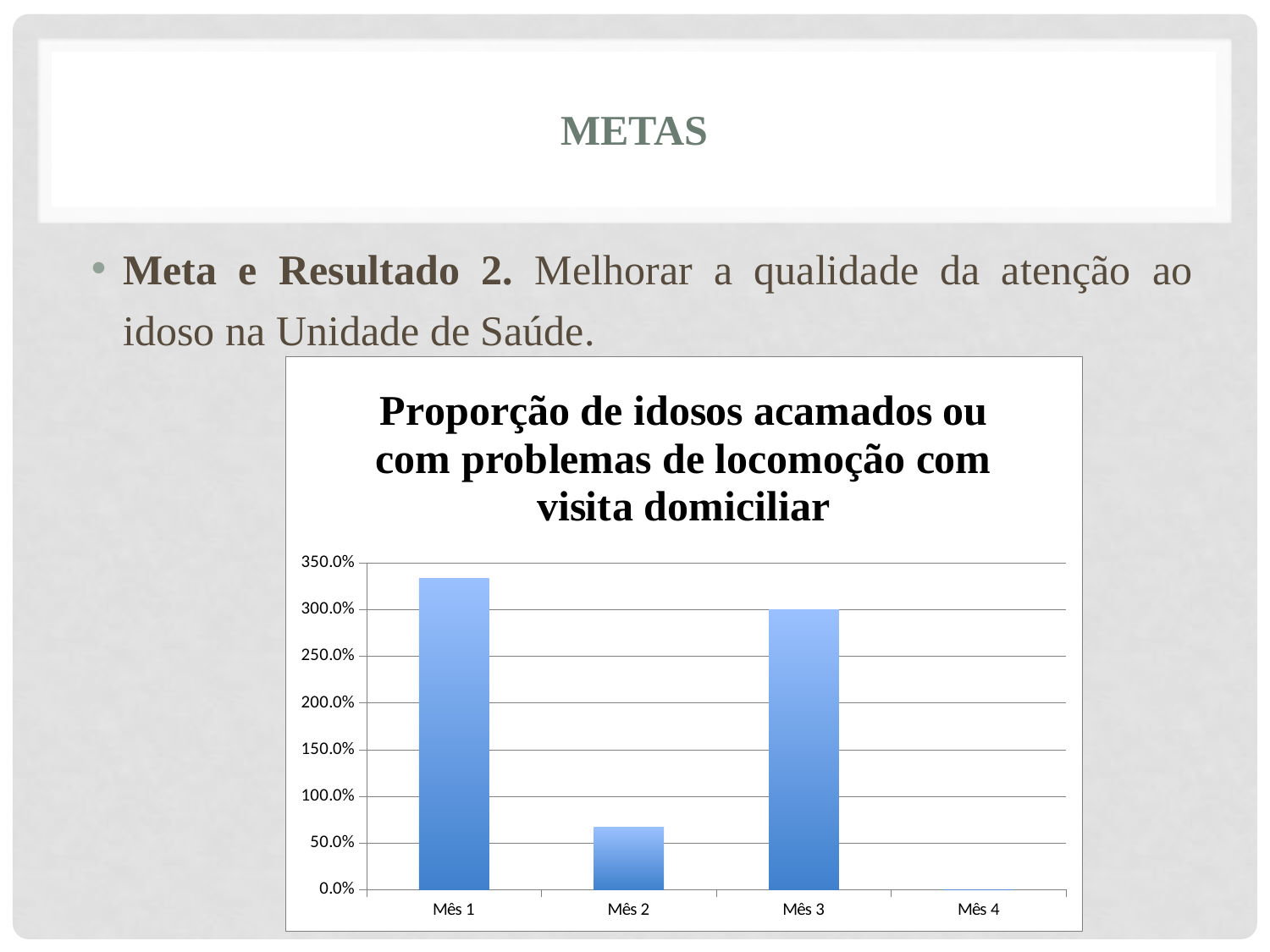
What is the highest value shown on the y axis of the chart? 350.0% Which is larger, the value for Mês 2 or the value for Mês 3? Mês 3 What is the title of the chart? Proporção de idosos acamados ou com problemas de locomoção com visita domiciliar How many month categories are shown on the x axis of the chart? 4 Is the value for Mês 3 greater or less than 250.0%? greater Is the value for Mês 1 greater or less than 300.0%? greater What kind of chart is shown on the slide? bar chart Which of the months with a visible bar has the lowest value? Mês 2 Is the value for Mês 2 greater or less than 100.0%? less Which is larger, the value for Mês 1 or the value for Mês 3? Mês 1 Which month has the tallest bar in the chart? Mês 1